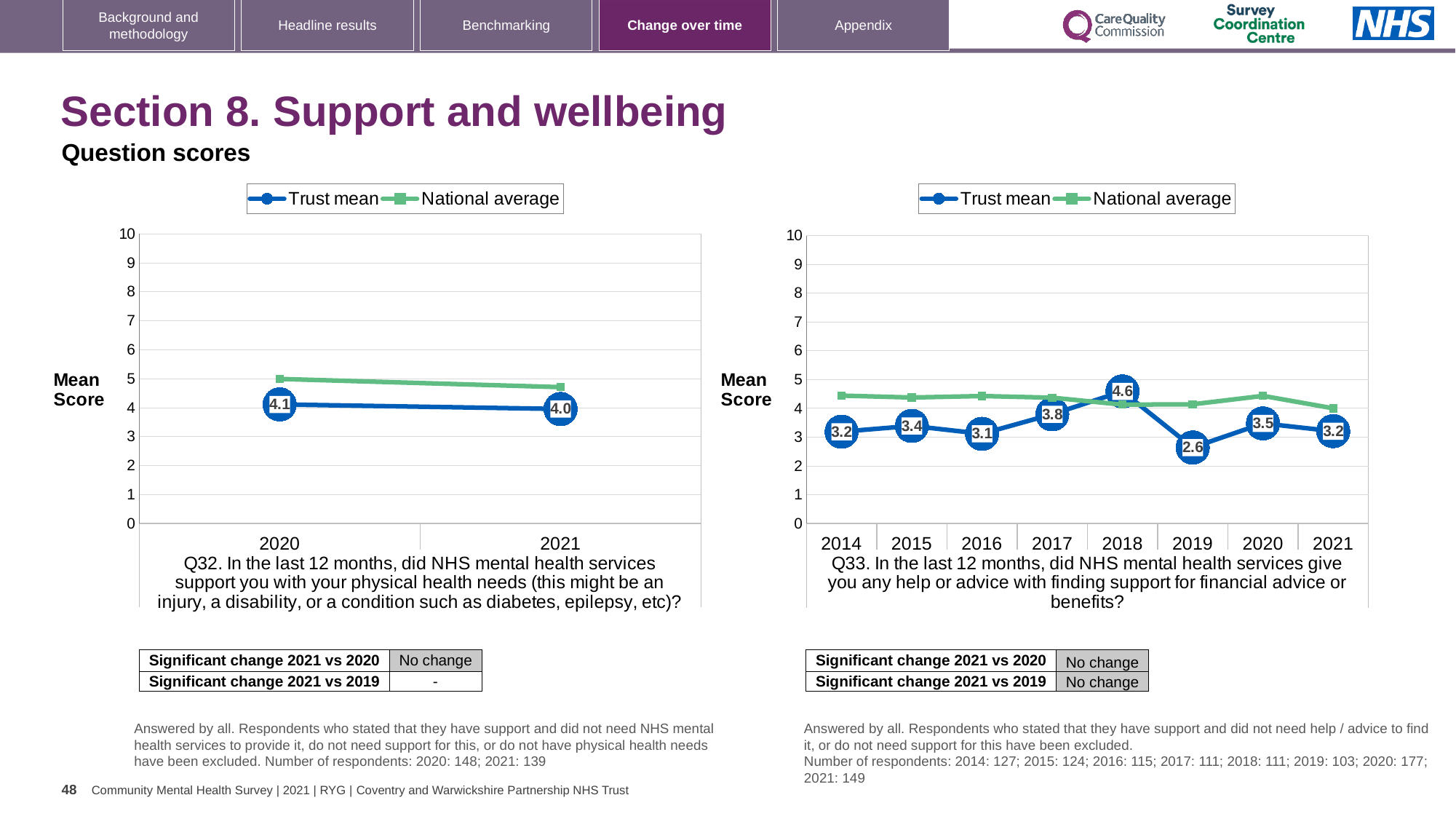
How many series does the legend of the Q32 chart on the left list? 2 In the Q33 chart on the right, what is the Trust mean for 2019? 2.6 In the Q32 chart on the left, is the National average for 2020 greater or less than 4? greater In the Q33 chart on the right, how many years are shown on the x axis? 8 In the Q32 chart on the left, what is the Trust mean for 2020? 4.1 In the Q32 chart on the left, what is the Trust mean for 2021? 4.0 In the Q33 chart on the right, which year has the highest Trust mean? 2018 What type of chart is the Q33 chart on the right? Line chart In the Q33 chart on the right, which year has the lowest Trust mean? 2019 In the Q33 chart on the right, what is the difference between the Trust mean in 2018 and in 2019? 2.0 In the Q33 chart on the right, what is the Trust mean for 2018? 4.6 In the Q33 chart on the right, which is larger, the Trust mean for 2017 or for 2020? 2017